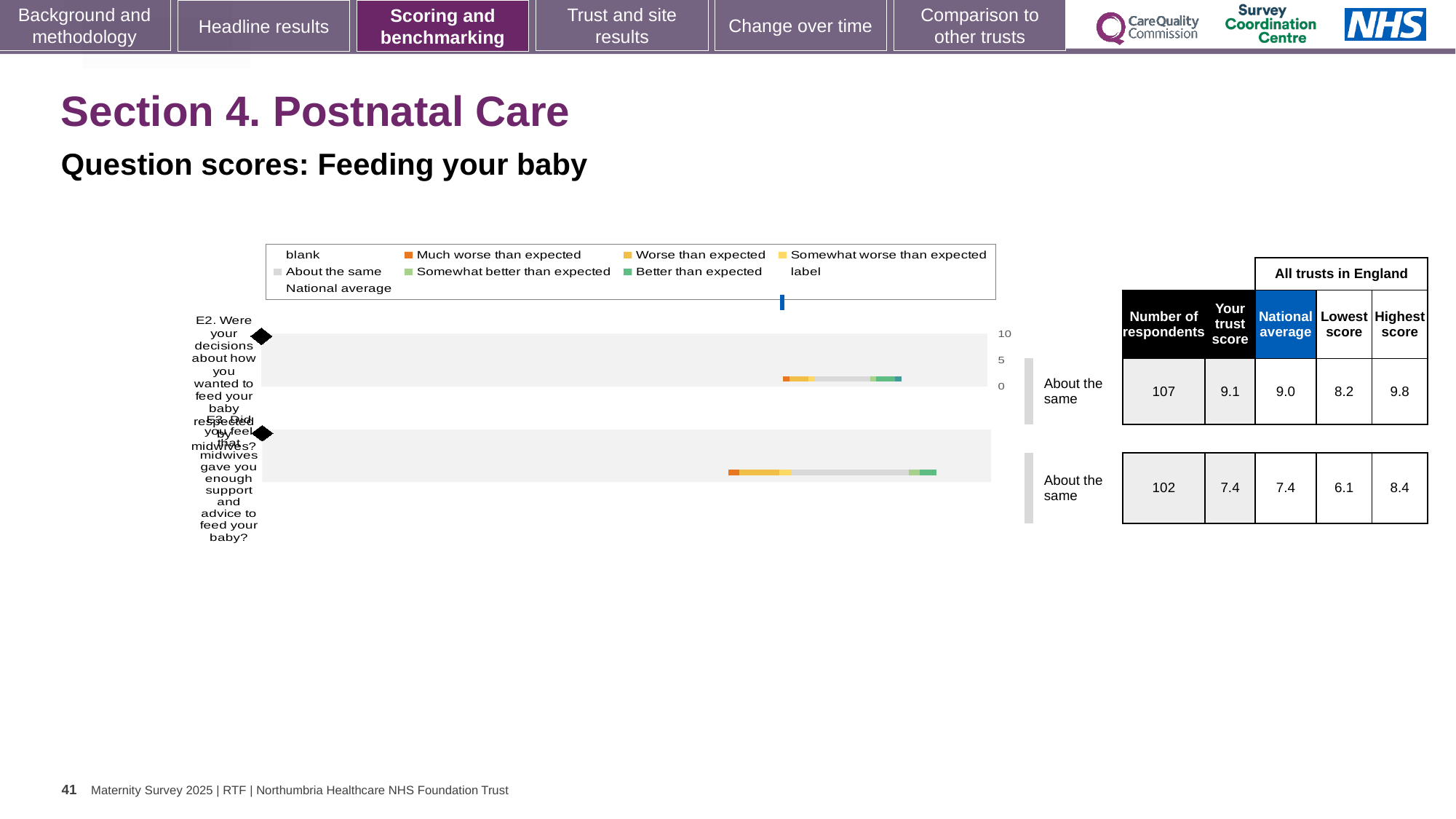
How many respondents answered question E3? 102 What kind of chart is used to show the question scores for Feeding your baby? bar chart Which question has the higher trust score, E2 or E3? E2 What is the difference between the highest and lowest scores for question E3? 2.3 How many questions (categories) are plotted in the Feeding your baby chart? 2 What is the 'Your trust score' for question E2 about decisions on how you wanted to feed your baby being respected by midwives? 9.1 What is the highest score among all trusts in England for question E2? 9.8 What is the difference between the trust score and the national average for question E2? 0.1 What is the national average for question E2? 9.0 What is the 'Your trust score' for question E3 about midwives giving enough support and advice to feed your baby? 7.4 What is the lowest score among all trusts in England for question E3? 6.1 What benchmark category is shown next to both E2 and E3 in the chart? About the same